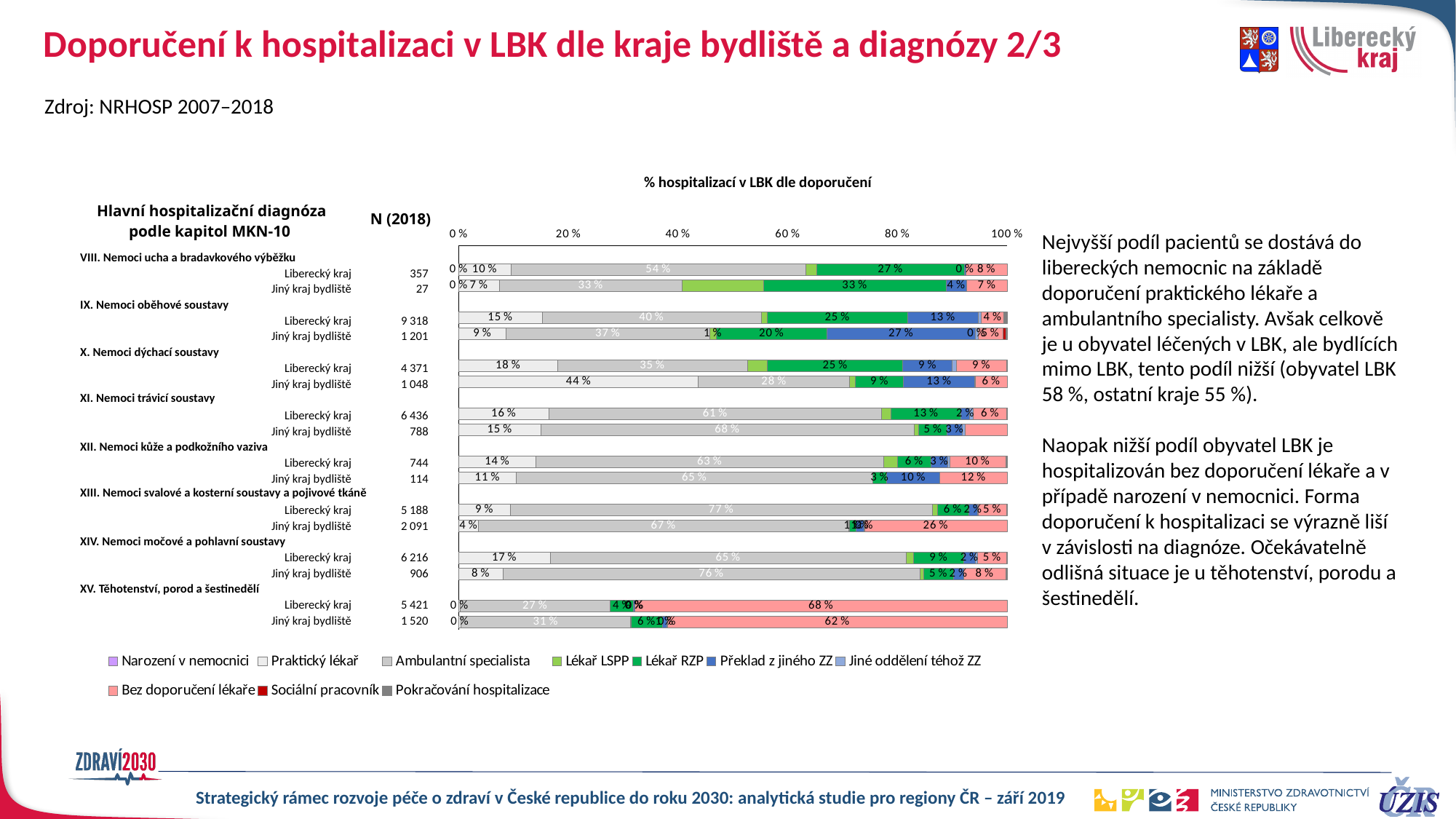
How many diagnosis groups (MKN-10 chapters) are shown in the chart? 8 How many series does the chart legend list? 10 What is the share of 'Lékař RZP' for Jiný kraj bydliště in group VIII. Nemoci ucha a bradavkového výběžku? 33 % In group XV. Těhotenství, porod a šestinedělí, what is the difference between the 'Bez doporučení lékaře' share for Liberecký kraj and for Jiný kraj bydliště? 6 percentage points In group X. Nemoci dýchací soustavy, which has the larger 'Praktický lékař' share: Liberecký kraj or Jiný kraj bydliště? Jiný kraj bydliště What is the N (2018) value for Liberecký kraj in group IX. Nemoci oběhové soustavy? 9 318 What is the share of 'Bez doporučení lékaře' for Liberecký kraj in group XV. Těhotenství, porod a šestinedělí? 68 % What kind of chart is shown on the slide? stacked bar chart What is the share of 'Ambulantní specialista' for Liberecký kraj in group XIII. Nemoci svalové a kosterní soustavy a pojivové tkáně? 77 % What is the share of 'Praktický lékař' for Jiný kraj bydliště in group X. Nemoci dýchací soustavy? 44 % What is the title of the chart? % hospitalizací v LBK dle doporučení What is the share of 'Ambulantní specialista' for Jiný kraj bydliště in group XIV. Nemoci močové a pohlavní soustavy? 76 %